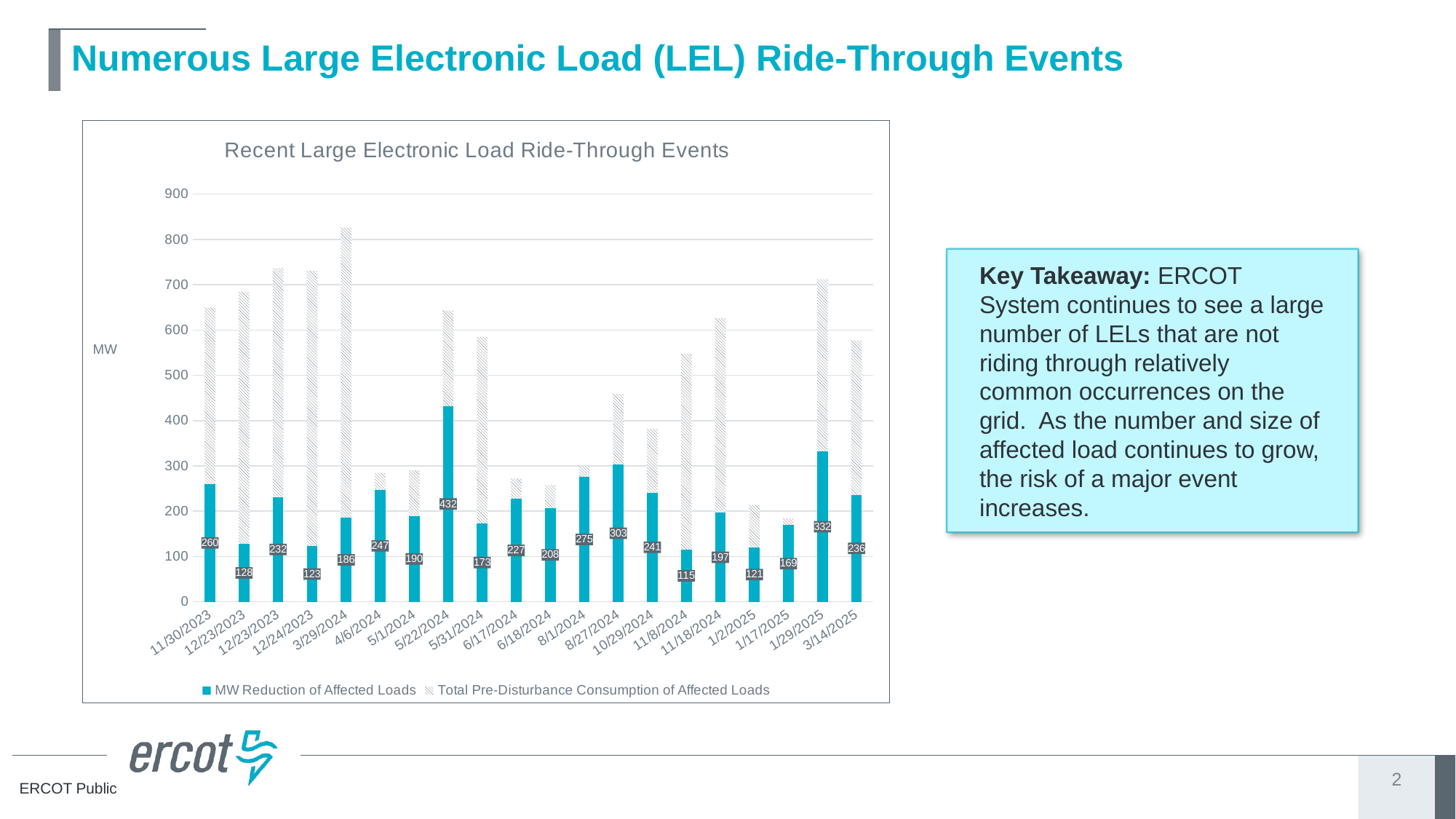
How many event dates are shown on the x axis of the chart? 20 Which event has a larger MW Reduction of Affected Loads, 8/1/2024 or 8/27/2024? 8/27/2024 What is the difference between the MW Reduction of Affected Loads on 5/22/2024 and on 11/8/2024? 317 How many series does the chart legend list? 2 Which event date has the highest MW Reduction of Affected Loads? 5/22/2024 What type of chart is shown on the slide? bar chart Which event date has the lowest MW Reduction of Affected Loads? 11/8/2024 Is the Total Pre-Disturbance Consumption of Affected Loads for the 4/6/2024 event greater or less than 300 MW? less What is the MW Reduction of Affected Loads for the 1/29/2025 event? 332 What is the MW Reduction of Affected Loads for the 5/22/2024 event? 432 What is the title of the chart? Recent Large Electronic Load Ride-Through Events